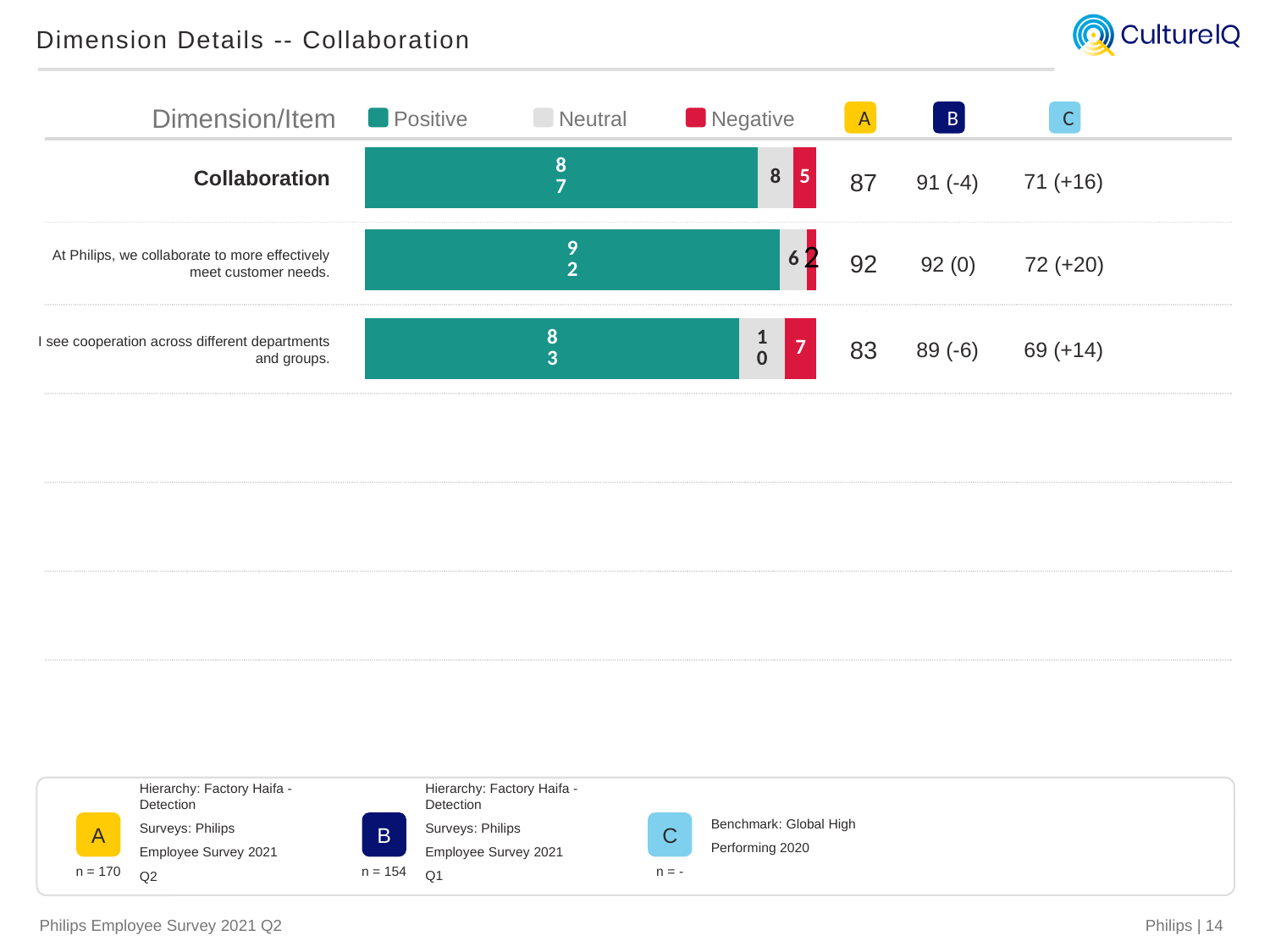
What kind of chart is shown on the slide? Stacked bar chart What is the Negative value for the item "I see cooperation across different departments and groups."? 7 What is the Positive value for the Collaboration dimension bar? 87 What is the Neutral value for the item "At Philips, we collaborate to more effectively meet customer needs."? 6 How many series does the legend list? 3 Which row has the lowest Positive value? I see cooperation across different departments and groups. How many rows (dimension and items) are plotted in the chart? 3 Which row has the highest Positive value? At Philips, we collaborate to more effectively meet customer needs. What is the value shown in column B for the Collaboration dimension? 91 (-4) Which has a larger Neutral value: the Collaboration dimension or "I see cooperation across different departments and groups."? I see cooperation across different departments and groups. What is the difference between the Positive values of "At Philips, we collaborate to more effectively meet customer needs." and "I see cooperation across different departments and groups."? 9 What is the total of the stacked bar for the Collaboration dimension? 100